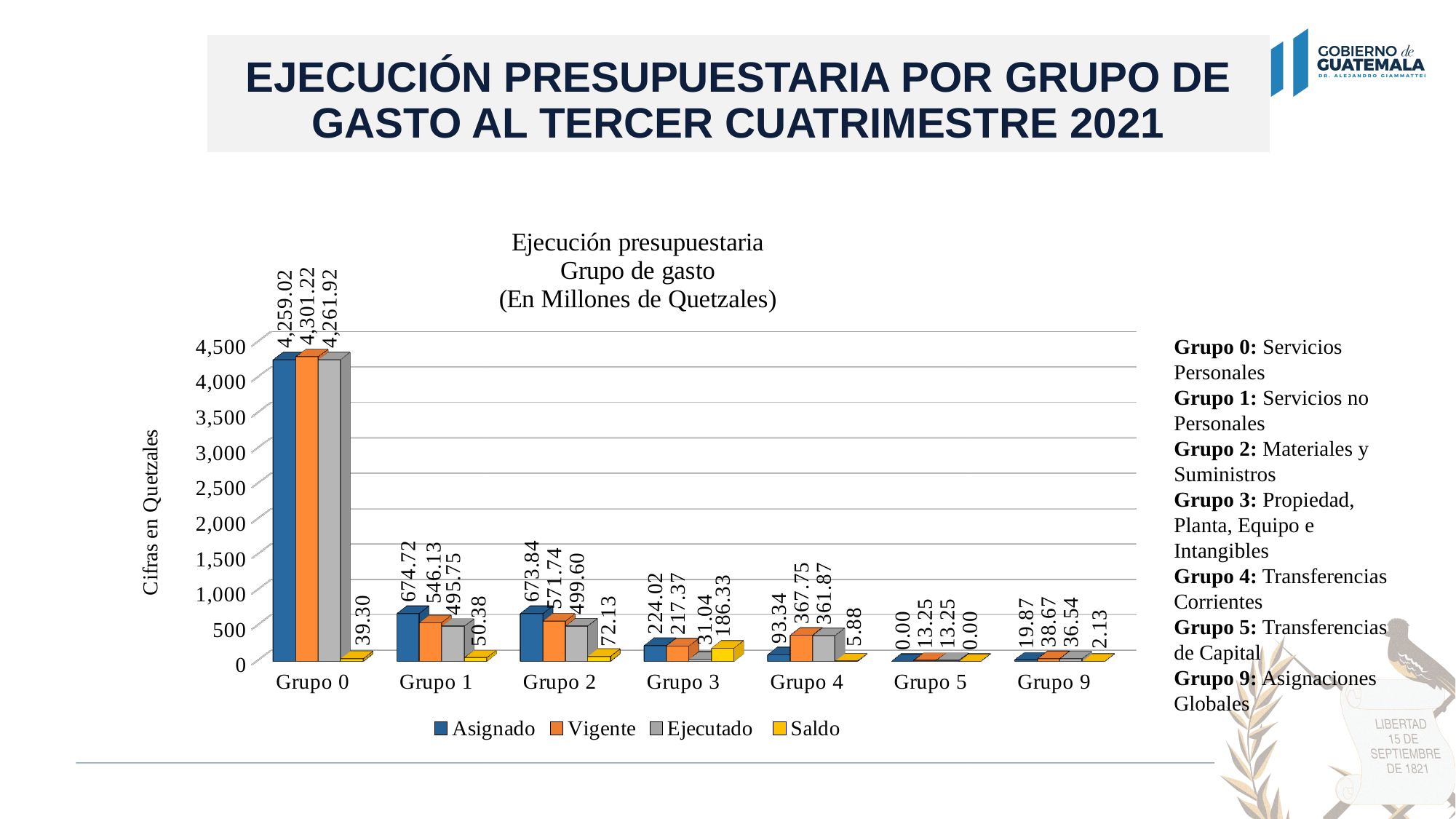
What is the Saldo value for Grupo 2? 72.13 What is the difference between the Asignado and Vigente values for Grupo 1? 128.59 What kind of chart is shown on the slide? Bar chart What is the Asignado value for Grupo 4? 93.34 Which is larger, the Asignado value for Grupo 4 or the Vigente value for Grupo 4? Vigente What is the difference between the Vigente and Ejecutado values for Grupo 3? 186.33 What is the Ejecutado value for Grupo 3? 31.04 Which group has the lowest Ejecutado value? Grupo 5 What is the Vigente value for Grupo 0? 4,301.22 Which group has the highest Saldo value? Grupo 3 How many groups (categories) are shown on the x axis? 7 How many series does the legend list? 4